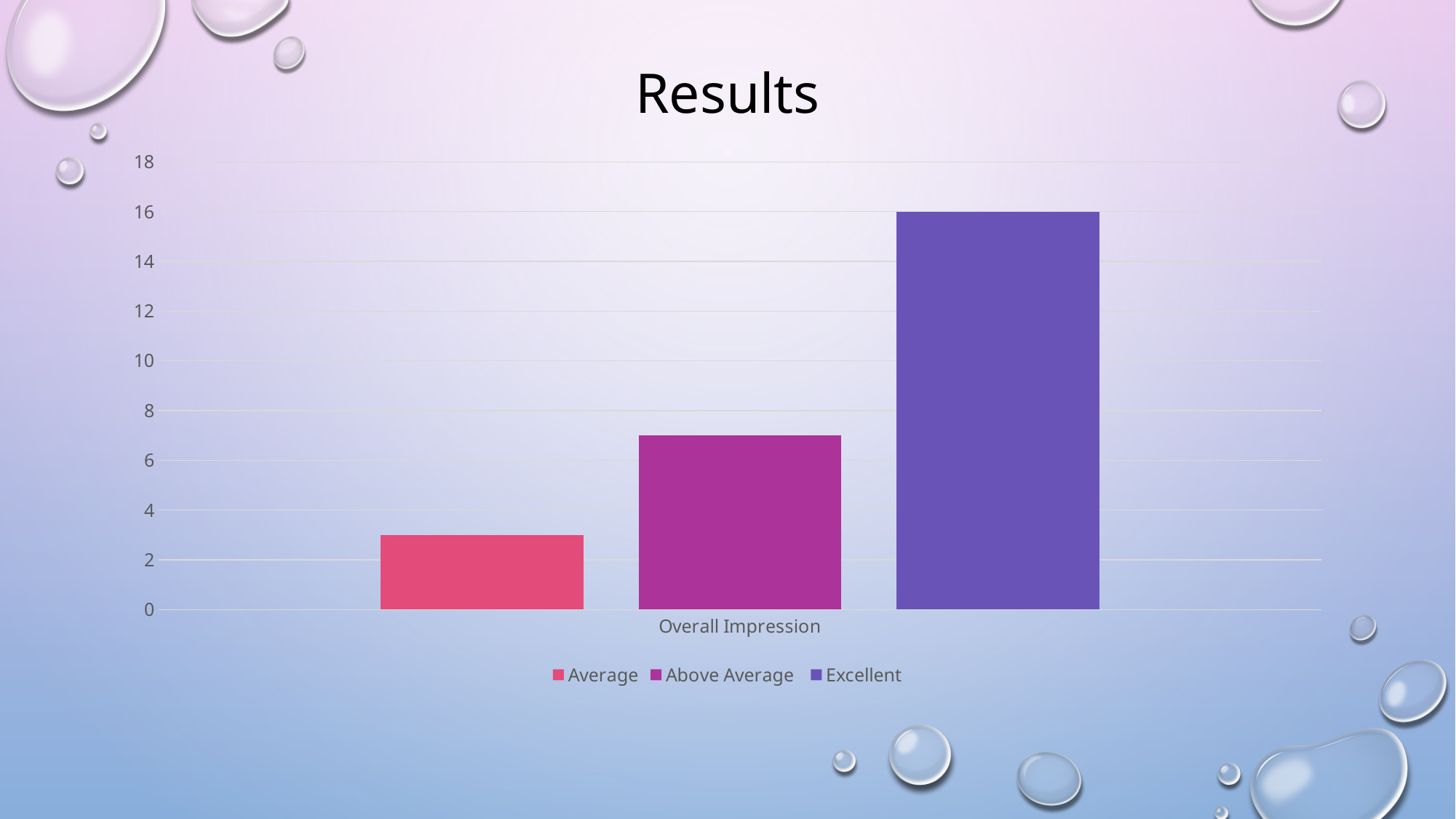
Which is larger for Overall Impression, Average or Above Average? Above Average How many series does the legend list? 3 Is the value for Average greater or less than 4? less Is the value for Above Average greater or less than 6? greater Is the value for Above Average greater or less than 8? less What is the title of the chart on the slide? Results Which series has the highest value for Overall Impression? Excellent What are the series names listed in the legend? Average, Above Average, Excellent What type of chart is shown on the slide? bar chart Which series has the lowest value for Overall Impression? Average What is the value for Excellent for Overall Impression? 16 How many categories are shown on the x axis? 1